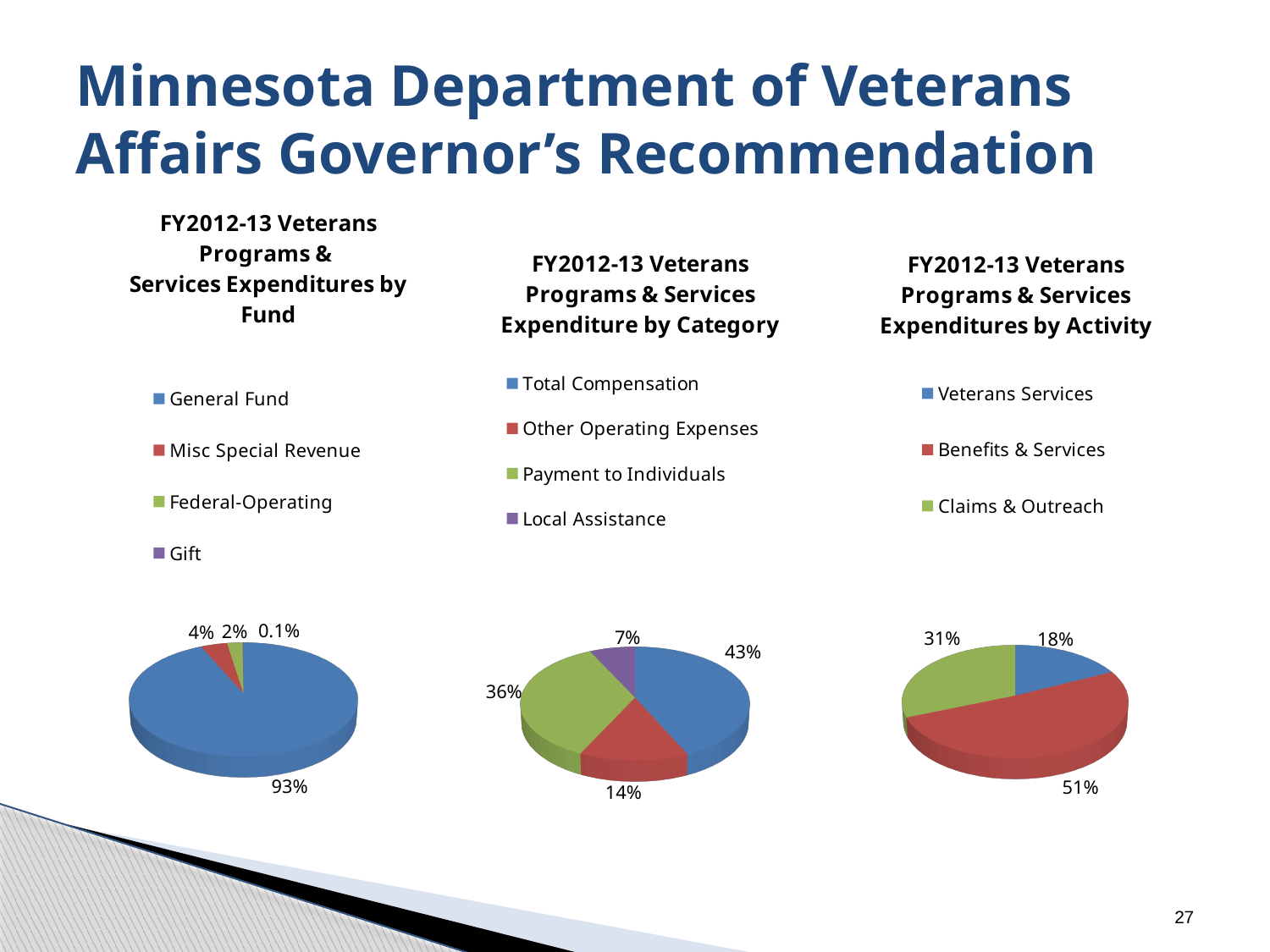
In the 'Expenditure by Category' pie chart, which category has the smallest share? Local Assistance In the 'Expenditure by Category' pie chart, what is the difference between the Total Compensation share and the Other Operating Expenses share? 29% In the 'Expenditures by Fund' pie chart, which fund has the smallest share? Gift In the 'Expenditures by Activity' pie chart, which activity has the largest share? Benefits & Services In the 'Expenditures by Fund' pie chart, what share does the General Fund have? 93% How many categories does the legend of the 'Expenditures by Fund' pie chart list? 4 In the 'Expenditure by Category' pie chart, what share is Total Compensation? 43% In the 'Expenditures by Activity' pie chart, what share is Benefits & Services? 51% What type of chart is used for the 'Expenditures by Activity' chart? Pie chart In the 'Expenditures by Fund' pie chart, what share does Misc Special Revenue have? 4% In the 'Expenditures by Activity' pie chart, which is larger: Veterans Services or Claims & Outreach? Claims & Outreach In the 'Expenditure by Category' pie chart, what share is Payment to Individuals? 36%